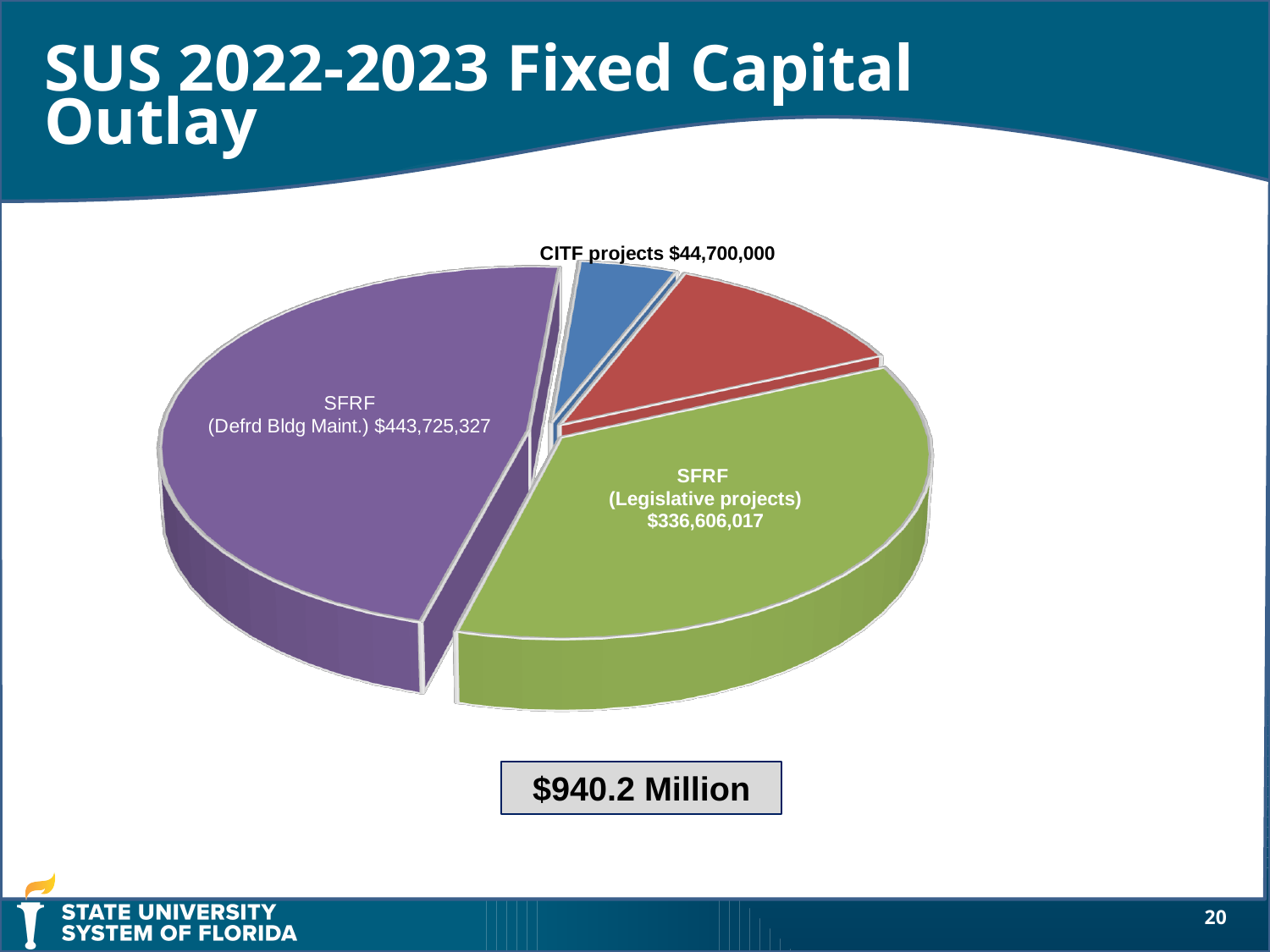
What is the value for SFRF (Defrd Bldg Maint.)? $443,725,327 What is the value for SFRF (Legislative projects)? $336,606,017 What total amount is shown in the box below the pie chart? $940.2 Million Which is larger, SFRF (Defrd Bldg Maint.) or SFRF (Legislative projects)? SFRF (Defrd Bldg Maint.) What kind of chart is shown on the slide? Pie chart What is the difference between SFRF (Defrd Bldg Maint.) and SFRF (Legislative projects)? $107,119,310 How many slices does the pie chart have? 4 Which slice of the pie is the largest? SFRF (Defrd Bldg Maint.) What is the value for CITF projects? $44,700,000 Which slice of the pie is the smallest? CITF projects What is the difference between SFRF (Legislative projects) and CITF projects? $291,906,017 What is the title of the chart on the slide? SUS 2022-2023 Fixed Capital Outlay